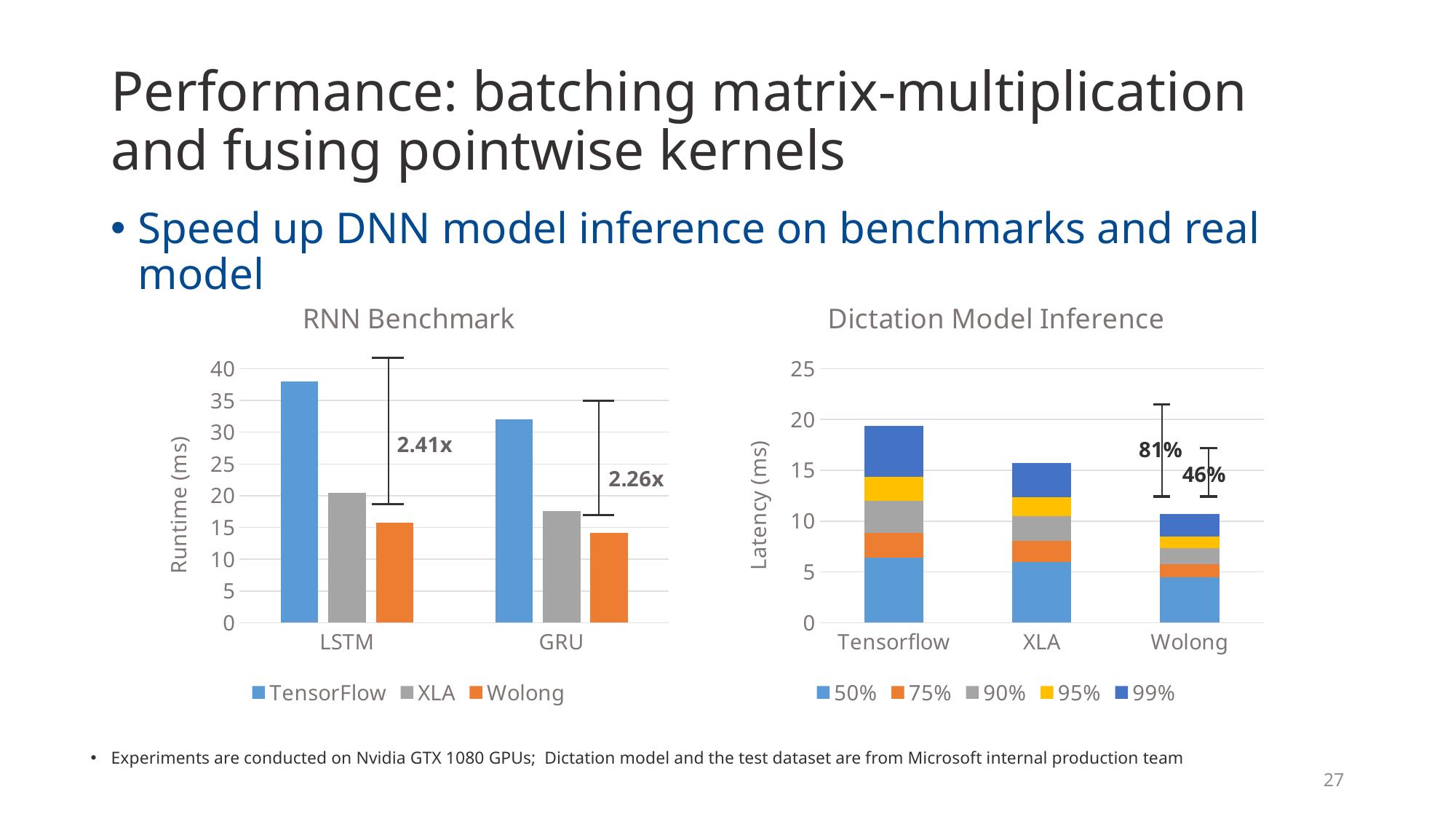
On the RNN Benchmark chart, what speedup is annotated for LSTM? 2.41x On the Dictation Model Inference chart, which category has the tallest stacked bar? Tensorflow On the Dictation Model Inference chart, is the total height of the Wolong bar greater or less than 15? less On the RNN Benchmark chart, which series has the highest runtime for LSTM? TensorFlow On the Dictation Model Inference chart, what is the y-axis label? Latency (ms) On the RNN Benchmark chart, what kind of chart is shown? bar chart On the RNN Benchmark chart, is the TensorFlow runtime for LSTM greater or less than 35? greater On the RNN Benchmark chart, how many series does the legend list? 3 On the Dictation Model Inference chart, how many series does the legend list? 5 On the RNN Benchmark chart, is the XLA runtime larger for LSTM or for GRU? LSTM On the RNN Benchmark chart, is the Wolong runtime for GRU greater or less than 15? less On the RNN Benchmark chart, how many categories are shown on the x axis? 2